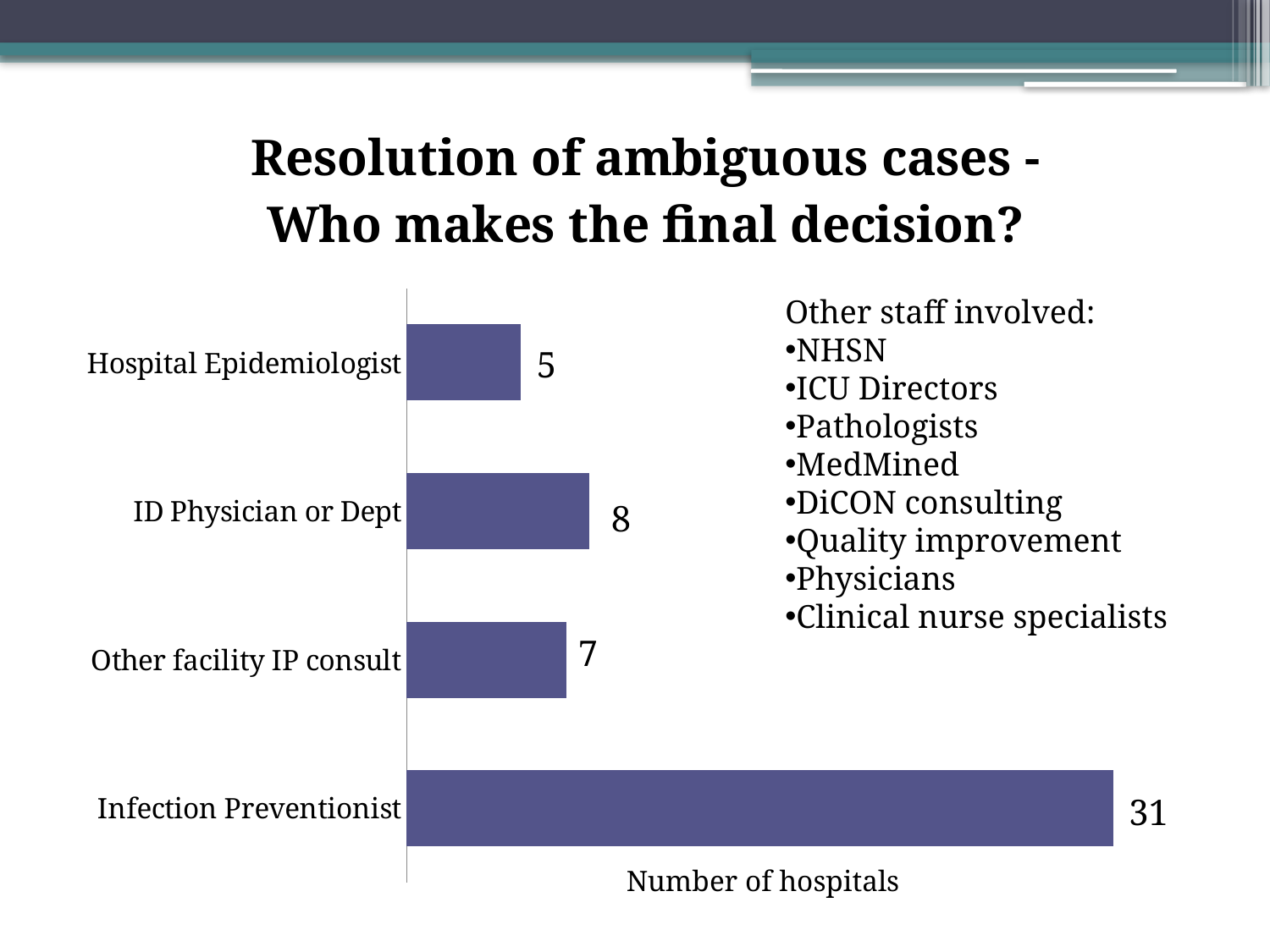
What is the value for ID Physician or Dept? 8 What is the value for Hospital Epidemiologist? 5 Which category has the highest number of hospitals? Infection Preventionist What is the value for Other facility IP consult? 7 What is the difference between the values for ID Physician or Dept and Hospital Epidemiologist? 3 Which category has the lowest number of hospitals? Hospital Epidemiologist What kind of chart is shown on the slide? Bar chart How many categories are shown in the chart? 4 What is the label on the horizontal axis of the chart? Number of hospitals What is the difference between the values for Infection Preventionist and ID Physician or Dept? 23 Which is larger, the value for ID Physician or Dept or the value for Other facility IP consult? ID Physician or Dept How many hospitals have the Infection Preventionist make the final decision? 31